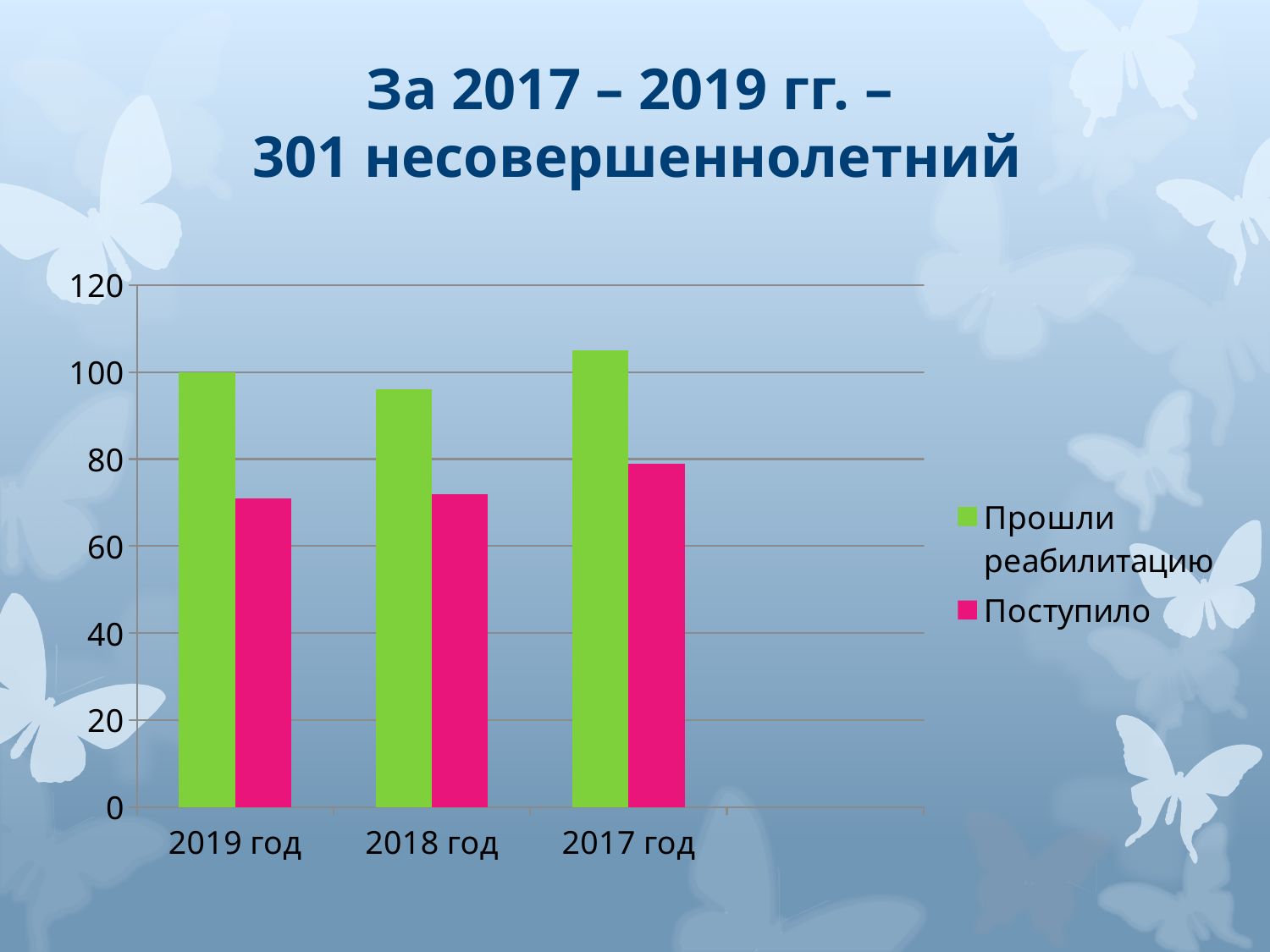
How many series does the legend list? 2 Is the value for "Прошли реабилитацию" in 2017 год greater or less than 100? greater How many year categories are shown on the x axis? 3 Which year has the highest value for "Поступило"? 2017 год What colour are the bars for the "Поступило" series? pink In 2019 год, which series has the larger value, "Прошли реабилитацию" or "Поступило"? Прошли реабилитацию Which year has the lowest value for "Прошли реабилитацию"? 2018 год Which year has the highest value for "Прошли реабилитацию"? 2017 год What kind of chart is shown on the slide? bar chart Is the value for "Прошли реабилитацию" in 2018 год greater or less than 100? less Is the value for "Поступило" in 2019 год greater or less than 60? greater